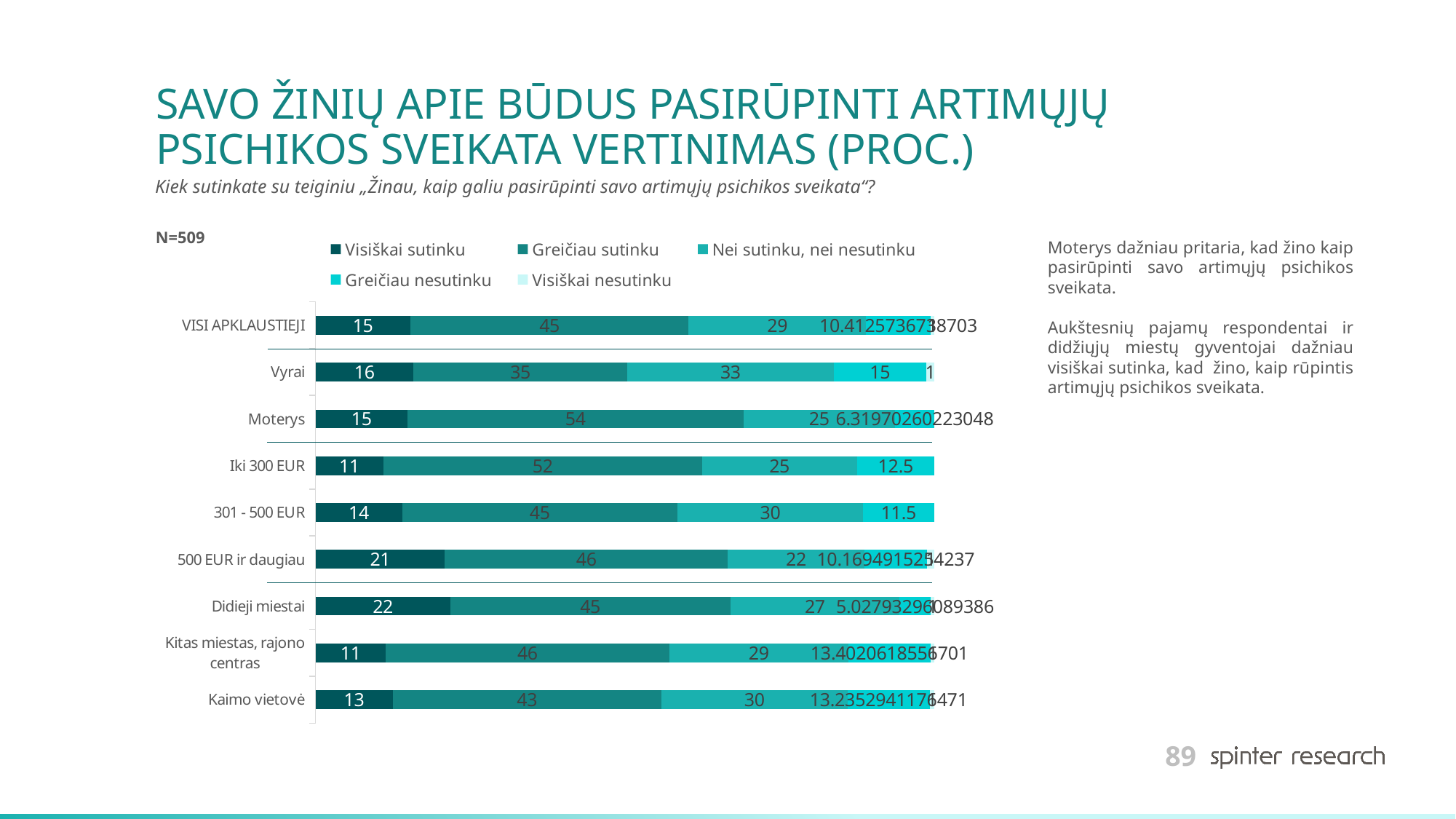
How many series does the legend list? 5 Which category has the lowest value for "Greičiau sutinku"? Vyrai What kind of chart is shown on the slide? Stacked bar chart What is the value of "Visiškai sutinku" for Didieji miestai? 22 What is the value of "Greičiau sutinku" for Moterys? 54 Which category has the highest value for "Visiškai sutinku"? Didieji miestai How many categories (bars) are shown in the chart? 9 What is the difference between the "Greičiau sutinku" values for Moterys and Vyrai? 19 What is the value of "Visiškai nesutinku" for Vyrai? 1 What is the value of "Greičiau nesutinku" for Iki 300 EUR? 12.5 What is the value of "Greičiau sutinku" for Vyrai? 35 Which has the larger "Greičiau sutinku" value, Vyrai or Moterys? Moterys